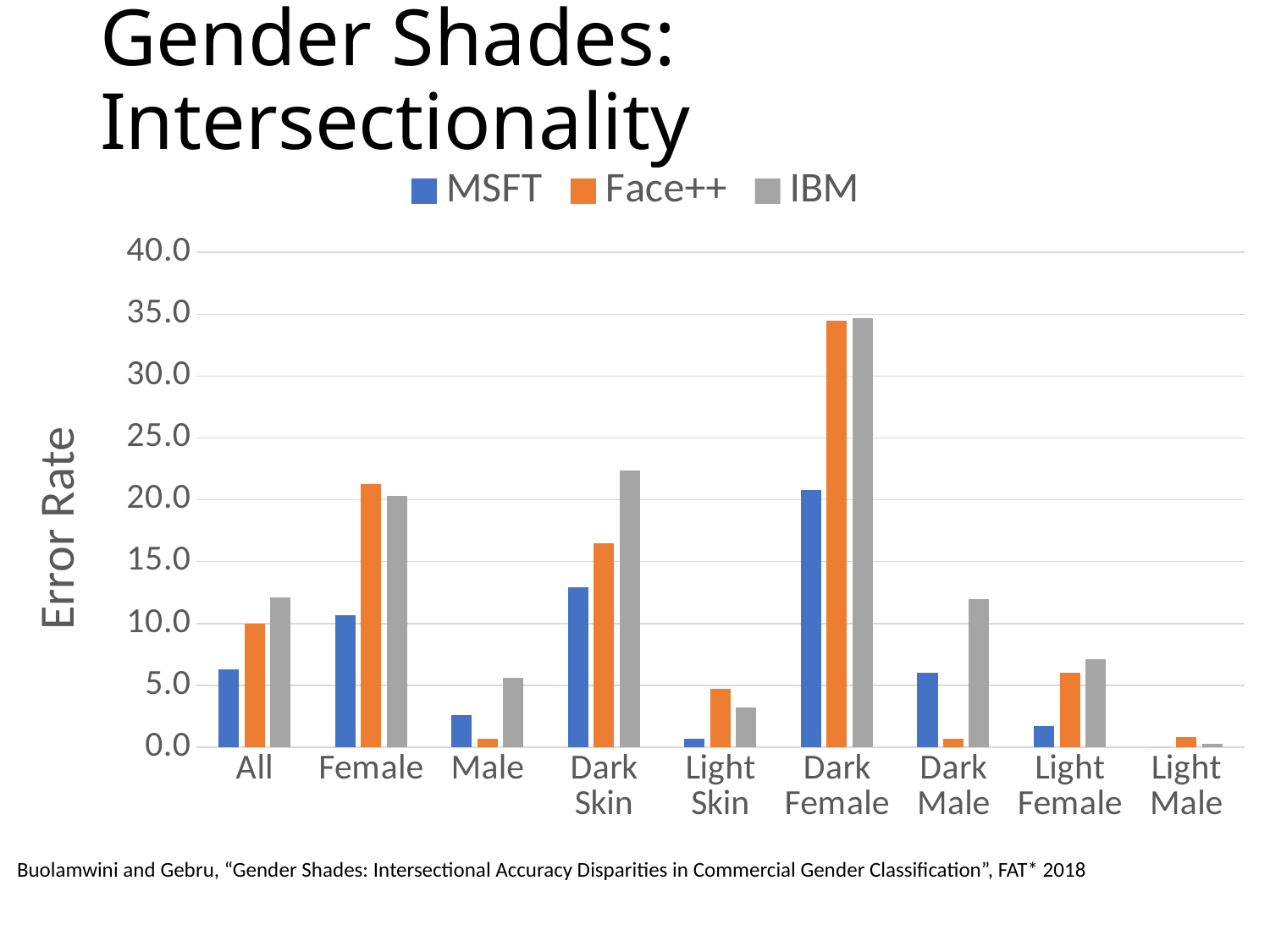
For Dark Male, which has the larger error rate, MSFT or IBM? IBM What kind of chart is shown on the slide? bar chart What is the label on the y axis? Error Rate Which colour represents Face++ in the legend? orange For Male, which has the larger error rate, Face++ or IBM? IBM Is the Face++ error rate for Dark Female greater or less than 30.0? greater How many categories are shown along the x axis? 9 Is the MSFT error rate for Dark Female greater or less than 25.0? less Is the IBM error rate for Dark Skin greater or less than 20.0? greater Which series has the lowest error rate for Light Skin? MSFT How many series does the legend list? 3 Which category has the highest IBM error rate? Dark Female